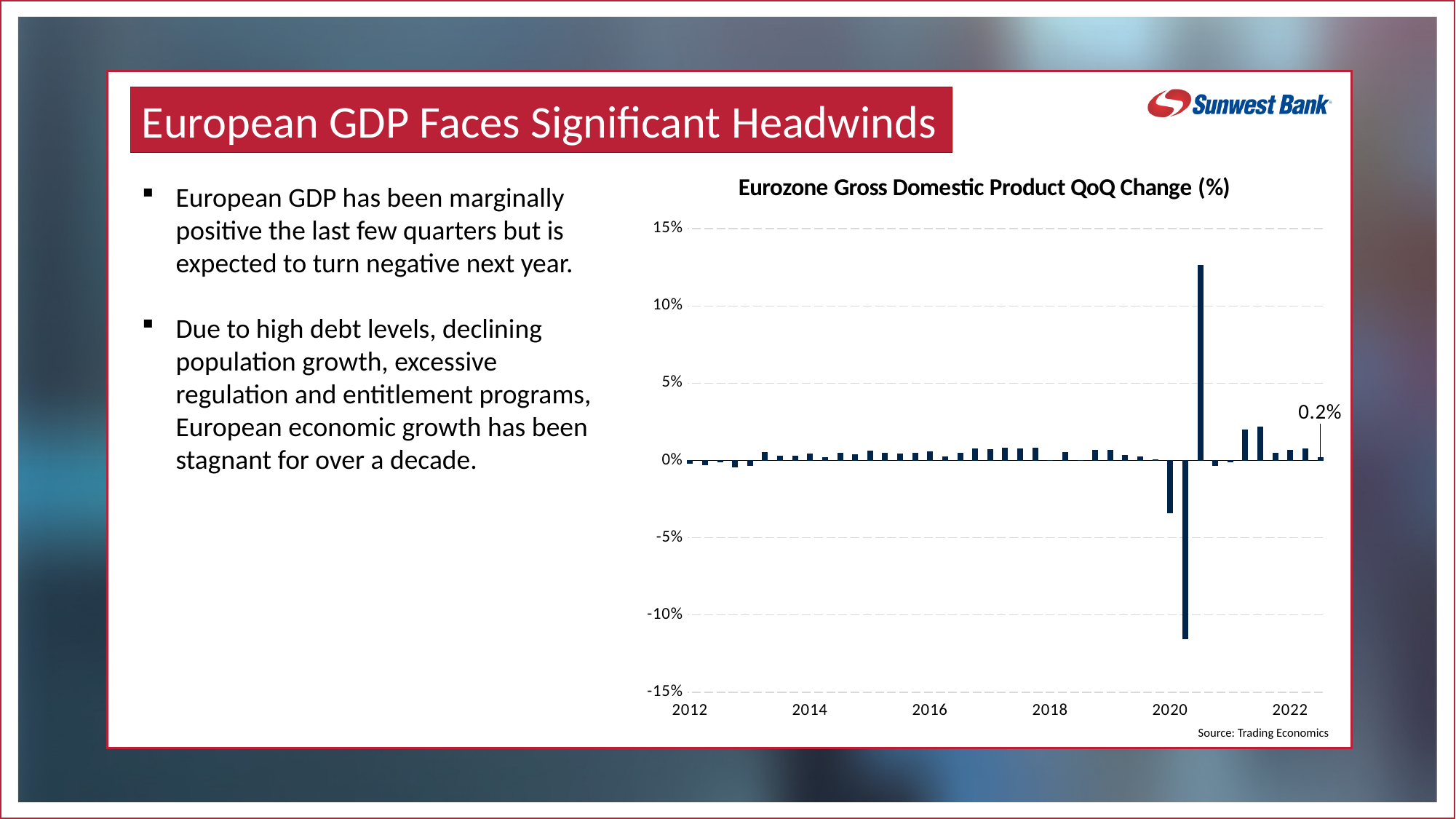
In which year on the x axis does the tallest positive bar occur? 2020 In which year on the x axis does the deepest negative bar occur? 2020 What value is labelled on the final bar of the chart (the most recent quarter)? 0.2% Is the value of the first negative bar in 2020 greater or less than -5%? greater Is the value of the final bar (0.2%) greater or less than 5%? less What is the highest value shown on the y axis? 15% What kind of chart is shown on the slide? Bar chart Is the value of the deepest negative bar greater or less than -10%? less What is the title of the chart? Eurozone Gross Domestic Product QoQ Change (%) How many year labels are shown on the x axis? 6 Are the bars from 2012 through 2019 mostly above or below 0%? Above